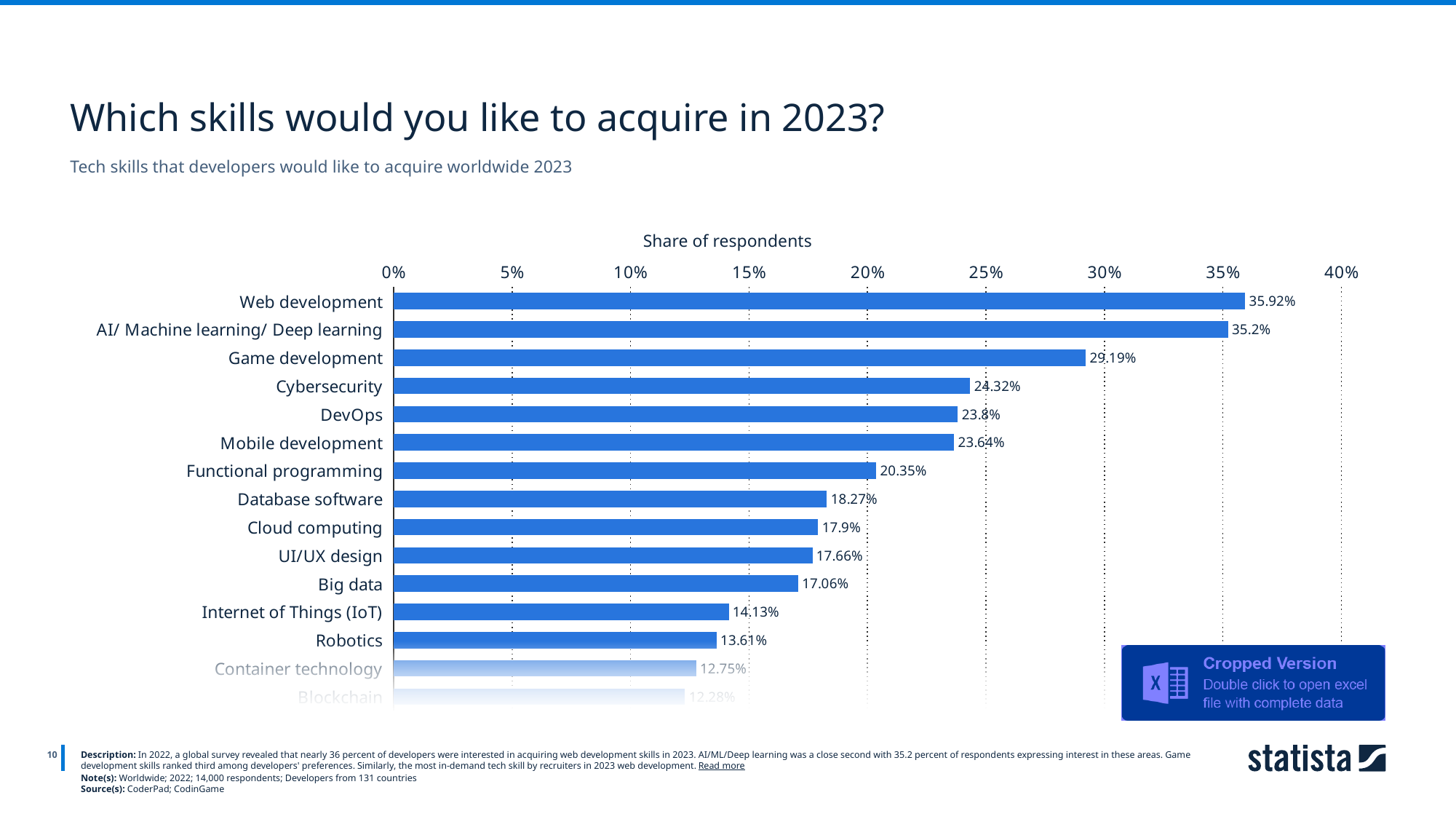
What kind of chart is shown on the slide? Bar chart Which skill has the highest share of respondents? Web development What share of respondents would like to acquire Cybersecurity skills? 24.32% What is the value for Web development? 35.92% What is the difference between Game development and Cybersecurity? 4.87 percentage points Is the value for Functional programming greater or less than 25%? less What is the difference between Web development and AI/ Machine learning/ Deep learning? 0.72 percentage points What is the value for Cloud computing? 17.9% What is the title of the horizontal axis? Share of respondents Which skill shown has the lowest share of respondents? Blockchain Which is larger, DevOps or Mobile development? DevOps What is the value for Internet of Things (IoT)? 14.13%